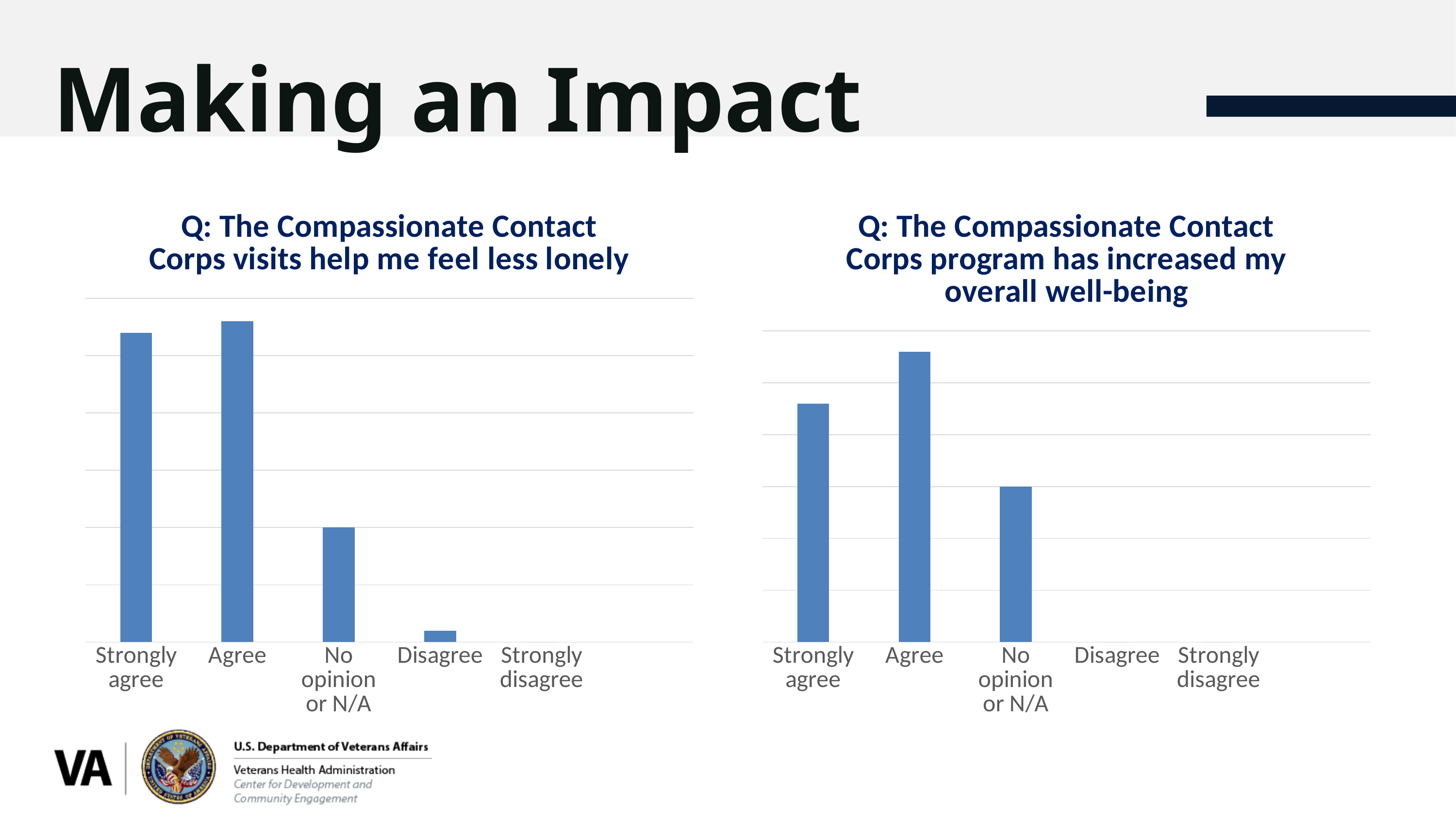
In the left chart (feel less lonely), which of 'Agree' or 'No opinion or N/A' has the larger value? Agree How many charts are shown on the slide? 2 What is the title of the slide? Making an Impact In the right chart (overall well-being), which of 'Strongly agree' or 'No opinion or N/A' has the larger value? Strongly agree What kind of chart is the left chart, titled 'Q: The Compassionate Contact Corps visits help me feel less lonely'? Bar chart In the right chart (overall well-being), do the values rise or fall moving from 'Agree' to 'Strongly disagree' along the x axis? Fall In the left chart (feel less lonely), which category shows no visible bar? Strongly disagree In the left chart (feel less lonely), which of 'Disagree' or 'No opinion or N/A' has the smaller value? Disagree In the left chart (feel less lonely), do the values rise or fall moving from 'Agree' to 'Strongly disagree' along the x axis? Fall How many categories are shown on the x axis of the right chart, titled 'Q: The Compassionate Contact Corps program has increased my overall well-being'? 5 In the right chart (overall well-being), which categories show no visible bar? Disagree and Strongly disagree In the right chart (overall well-being), which category has the highest bar? Agree